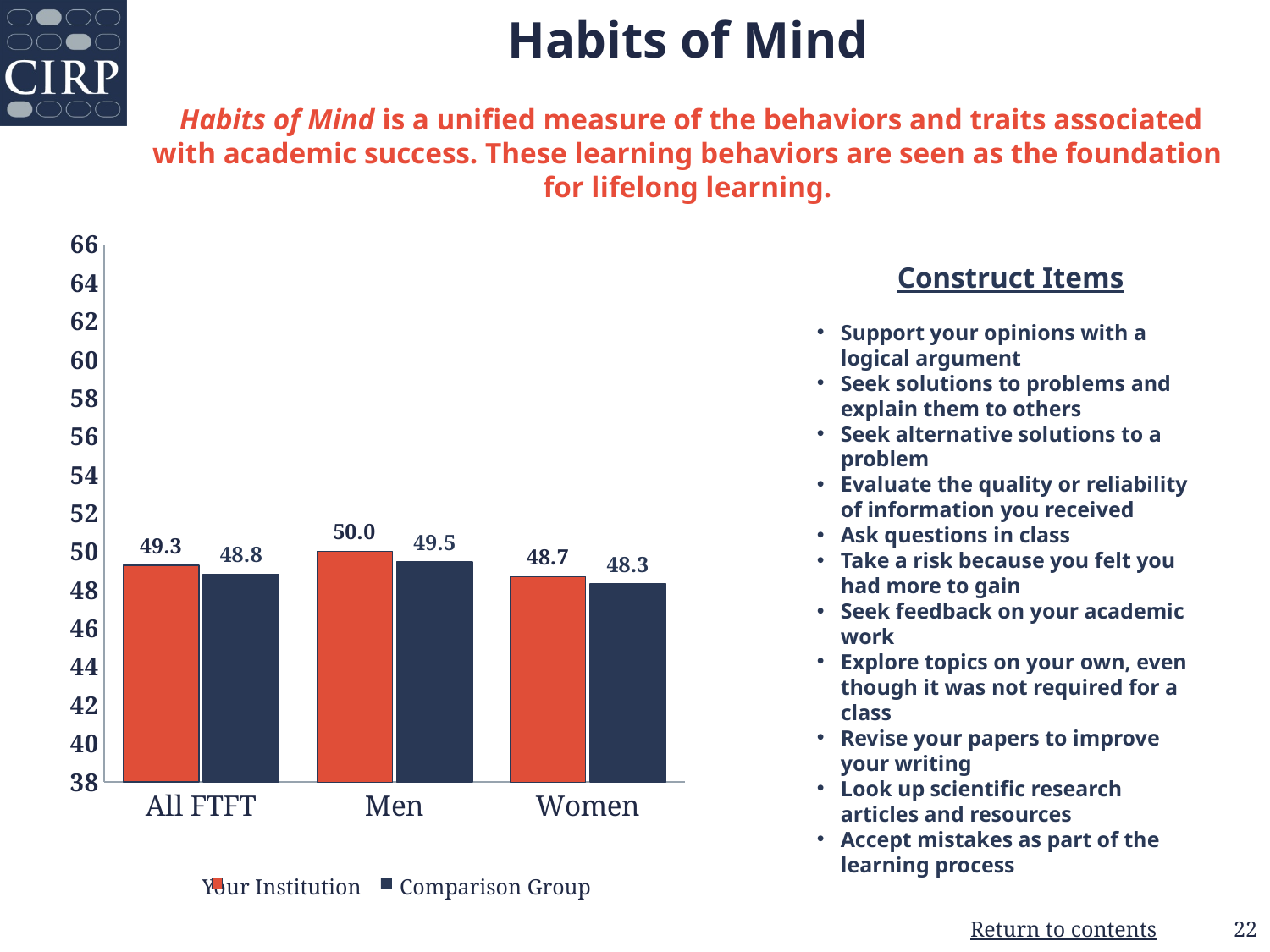
Which is larger for Women: the Your Institution value or the Comparison Group value? Your Institution What is the Comparison Group value for Women? 48.3 How many categories are shown on the x axis? 3 How many series does the legend list? 2 What kind of chart is shown on the slide? Bar chart What is the Your Institution value for Men? 50.0 What is the Your Institution value for All FTFT? 49.3 What is the Comparison Group value for All FTFT? 48.8 Which category has the lowest Comparison Group value? Women Which category has the highest Your Institution value? Men What is the difference between the Your Institution and Comparison Group values for Men? 0.5 What is the difference between the Your Institution values for Men and Women? 1.3